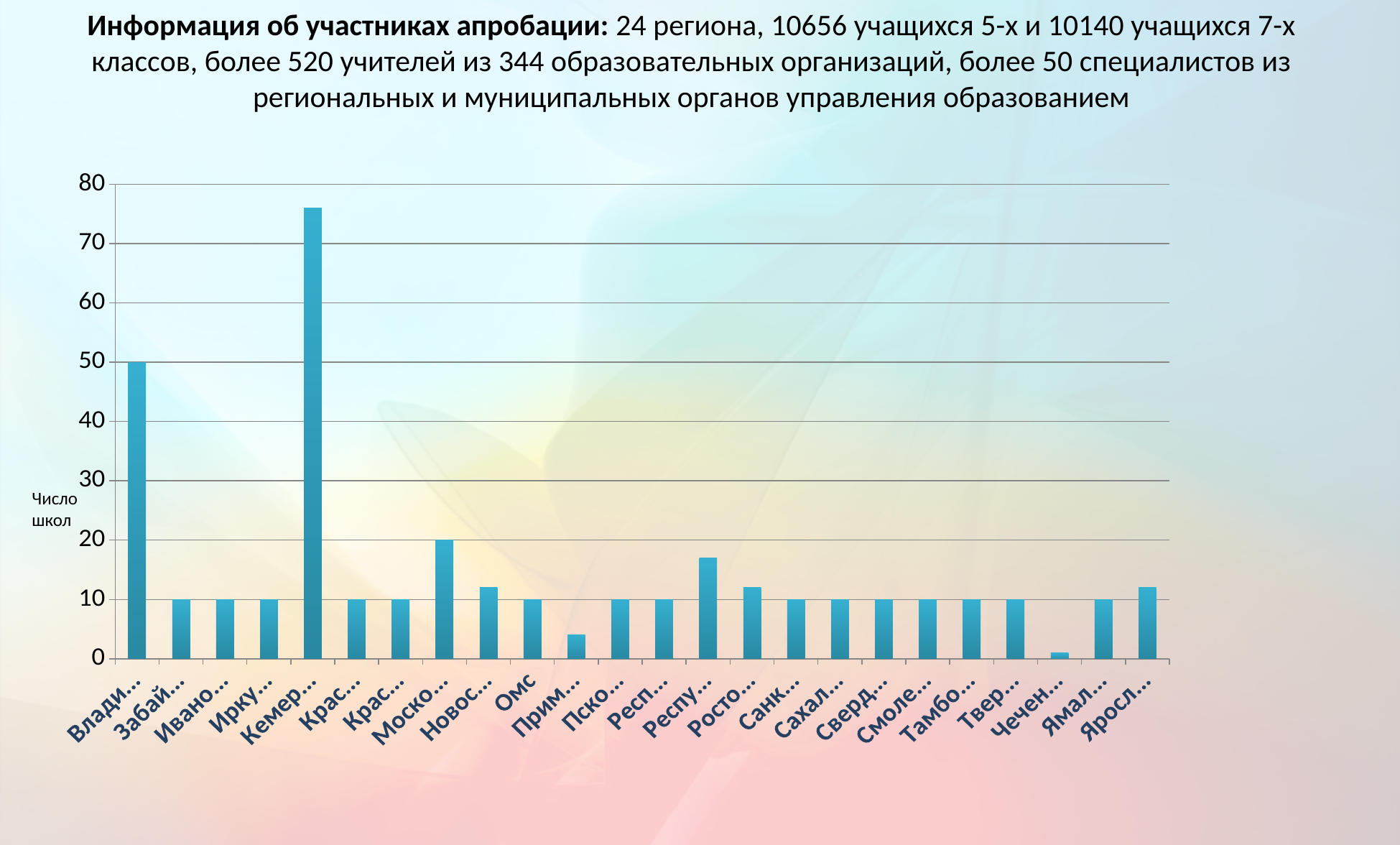
Is the value for Кемер… greater or less than 70? greater Which is larger, the value for Влади… or the value for Моско…? Влади… What is the value for Моско… in the chart? 20 Is the value for Респу… greater or less than 20? less Which region has the highest bar in the chart? Кемер… Is the value for Прим… greater or less than 10? less What kind of chart is shown on the slide? bar chart What is the difference between the values for Влади… and Моско…? 30 What is the value for Забай… in the chart? 10 How many bars (regions) are plotted in the chart? 24 What is the value for Влади… in the chart? 50 Which region has the lowest bar in the chart? Чечен…